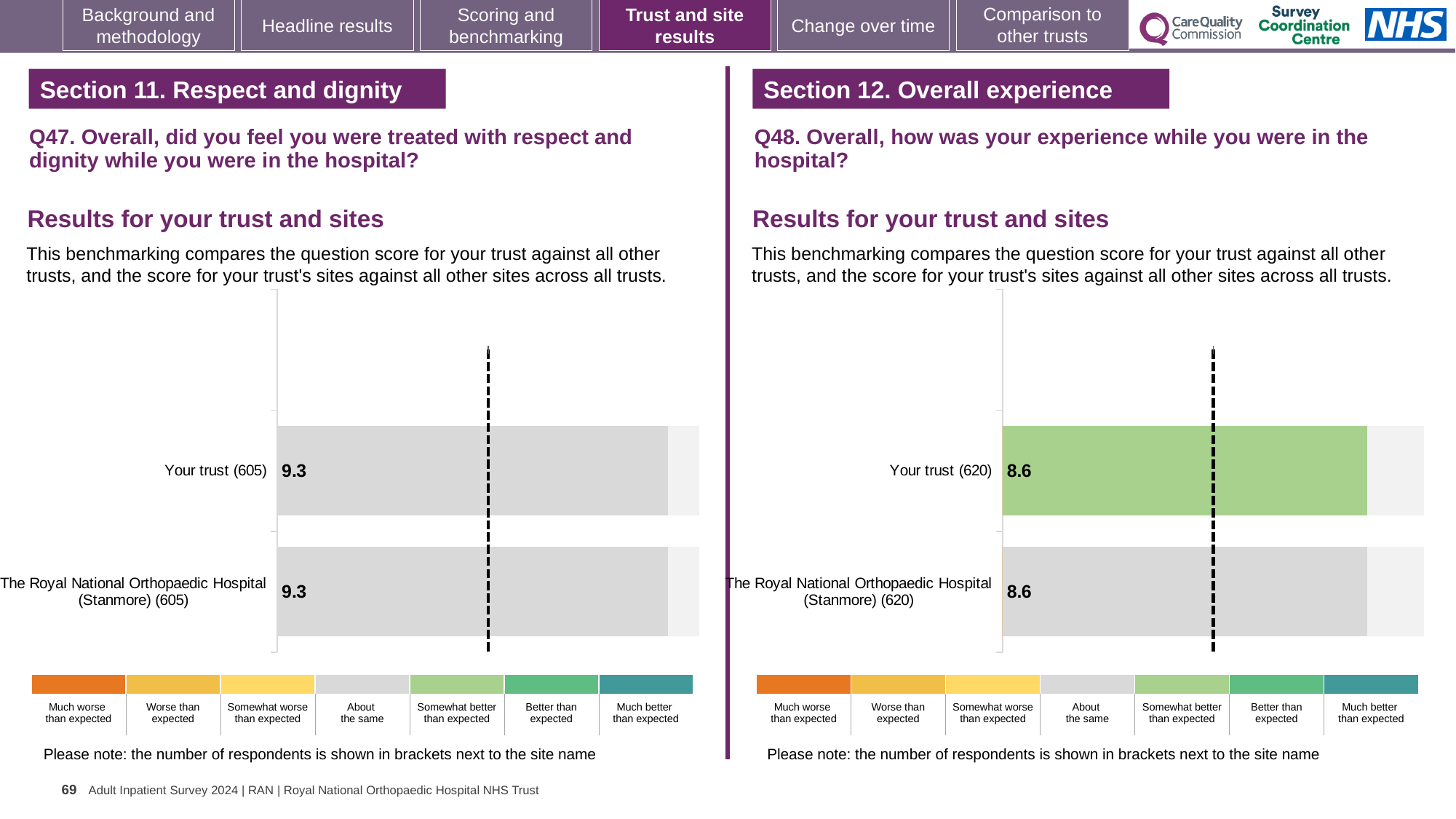
On the Q47 chart (left), what is the difference between the score for Your trust and the score for The Royal National Orthopaedic Hospital (Stanmore)? 0 On the Q48 chart (right), what is the score for The Royal National Orthopaedic Hospital (Stanmore)? 8.6 On the Q48 chart (right), which benchmark category does the green colour of the Your trust bar correspond to in the key? Somewhat better than expected Which is larger: the Your trust score on the Q47 chart (left) or the Your trust score on the Q48 chart (right)? Q47 chart (left) On the Q47 chart (left), how many respondents are shown in brackets for Your trust? 605 On the Q48 chart (right), how many respondents are shown in brackets for The Royal National Orthopaedic Hospital (Stanmore)? 620 What kind of chart is used on the Q47 chart (left)? Bar chart How many bars are plotted on the Q48 chart (right)? 2 On the Q47 chart (left), what is the score for Your trust? 9.3 What is the difference between the Your trust score on the Q47 chart (left) and the Your trust score on the Q48 chart (right)? 0.7 On the Q48 chart (right), what is the score for Your trust? 8.6 On the Q47 chart (left), what is the score for The Royal National Orthopaedic Hospital (Stanmore)? 9.3